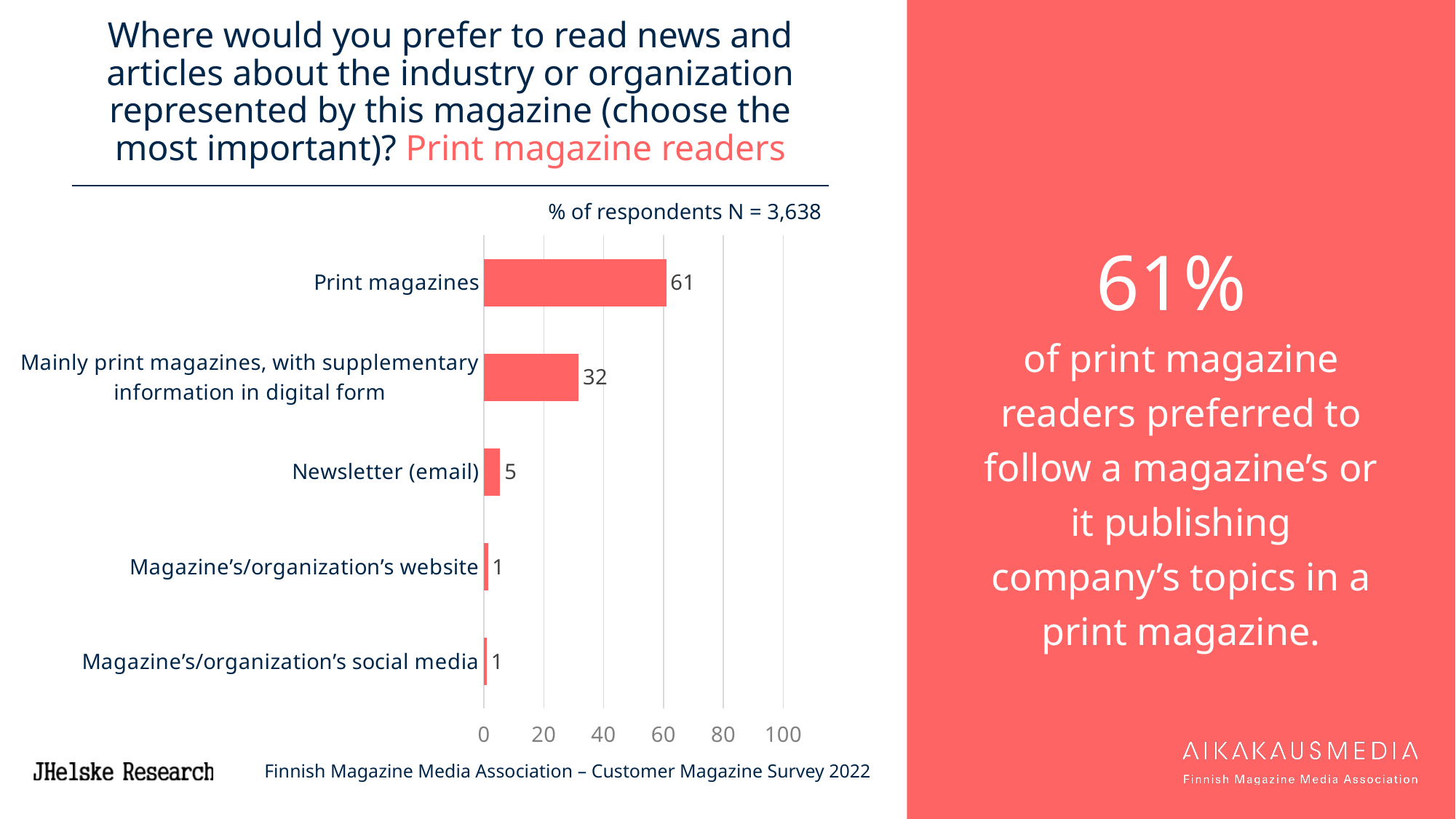
Which category has the highest value in the chart? Print magazines What is the difference between the values for 'Print magazines' and 'Mainly print magazines, with supplementary information in digital form'? 29 What type of chart is shown on the slide? Bar chart What is the value for 'Magazine's/organization's website'? 1 What is the number of respondents (N) stated above the chart? 3,638 Which is larger: the value for 'Newsletter (email)' or the value for 'Magazine's/organization's social media'? Newsletter (email) What is the value for 'Mainly print magazines, with supplementary information in digital form'? 32 What is the difference between the values for 'Mainly print magazines, with supplementary information in digital form' and 'Newsletter (email)'? 27 What percentage of print magazine readers chose 'Print magazines' as their preferred way to read news and articles? 61 Is the value for 'Print magazines' greater or less than 60? greater What is the value for 'Newsletter (email)'? 5 How many categories are shown in the chart? 5